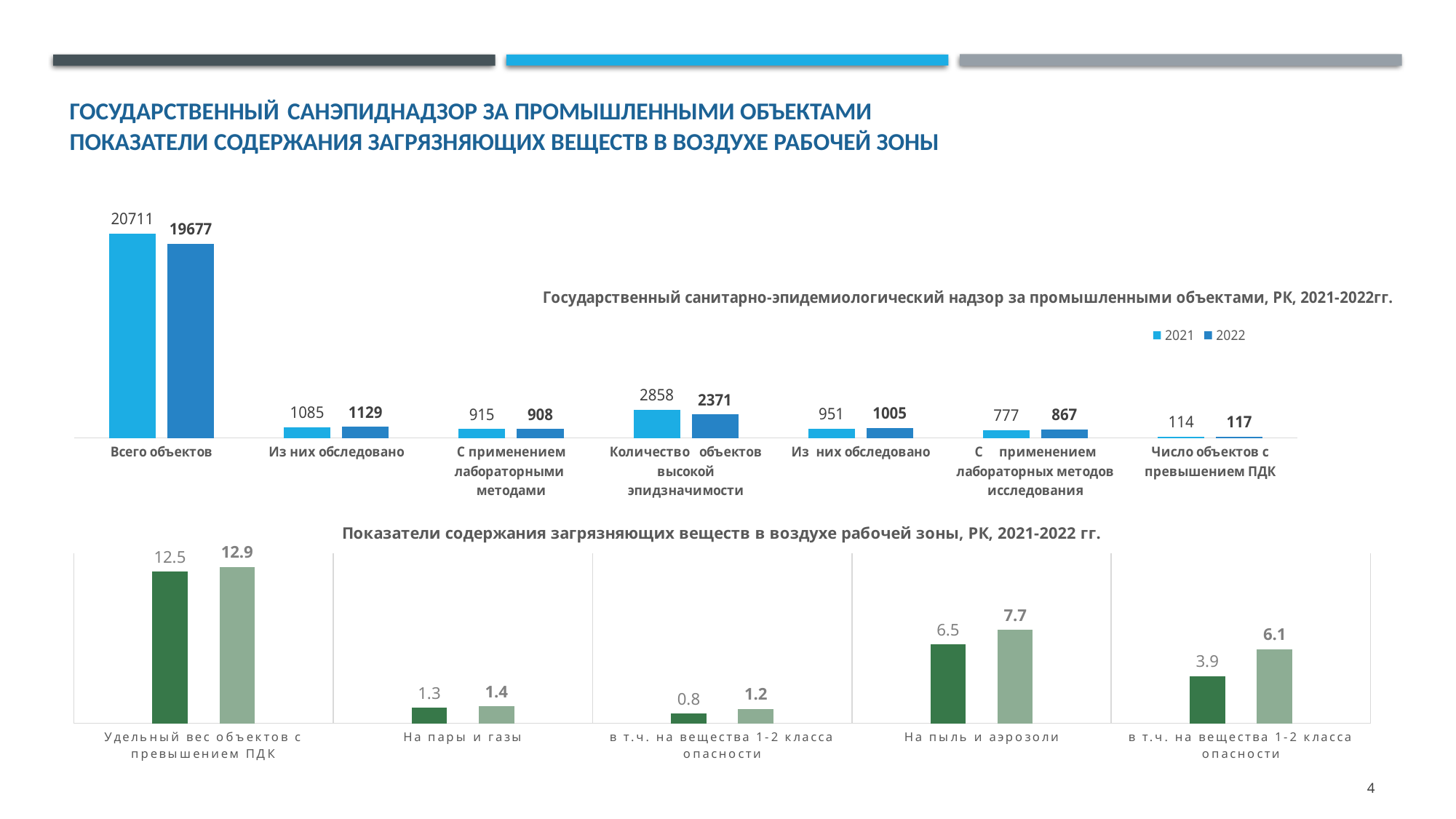
In the top chart 'Государственный санитарно-эпидемиологический надзор за промышленными объектами', how many categories are shown on the x axis? 7 In the top chart 'Государственный санитарно-эпидемиологический надзор за промышленными объектами', what is the difference between the 2021 and 2022 values for 'Всего объектов'? 1034 In the top chart 'Государственный санитарно-эпидемиологический надзор за промышленными объектами', how many series does the legend list? 2 What type of chart is the bottom chart 'Показатели содержания загрязняющих веществ в воздухе рабочей зоны'? bar chart In the bottom chart 'Показатели содержания загрязняющих веществ в воздухе рабочей зоны', what is the value of the light green bar for 'На пыль и аэрозоли'? 7.7 In the top chart 'Государственный санитарно-эпидемиологический надзор за промышленными объектами', what is the 2021 value for 'Всего объектов'? 20711 In the bottom chart 'Показатели содержания загрязняющих веществ в воздухе рабочей зоны', what is the difference between the light green and dark green bars for the rightmost category 'в т.ч. на вещества 1-2 класса опасности'? 2.2 In the bottom chart 'Показатели содержания загрязняющих веществ в воздухе рабочей зоны', what is the value of the dark green bar for 'Удельный вес объектов с превышением ПДК'? 12.5 In the top chart 'Государственный санитарно-эпидемиологический надзор за промышленными объектами', which category has the lowest 2021 value? Число объектов с превышением ПДК In the top chart 'Государственный санитарно-эпидемиологический надзор за промышленными объектами', what is the 2022 value for 'Число объектов с превышением ПДК'? 117 In the top chart 'Государственный санитарно-эпидемиологический надзор за промышленными объектами', what is the 2022 value for 'Количество объектов высокой эпидзначимости'? 2371 In the bottom chart 'Показатели содержания загрязняющих веществ в воздухе рабочей зоны', which is larger for 'На пары и газы': the dark green bar or the light green bar? the light green bar